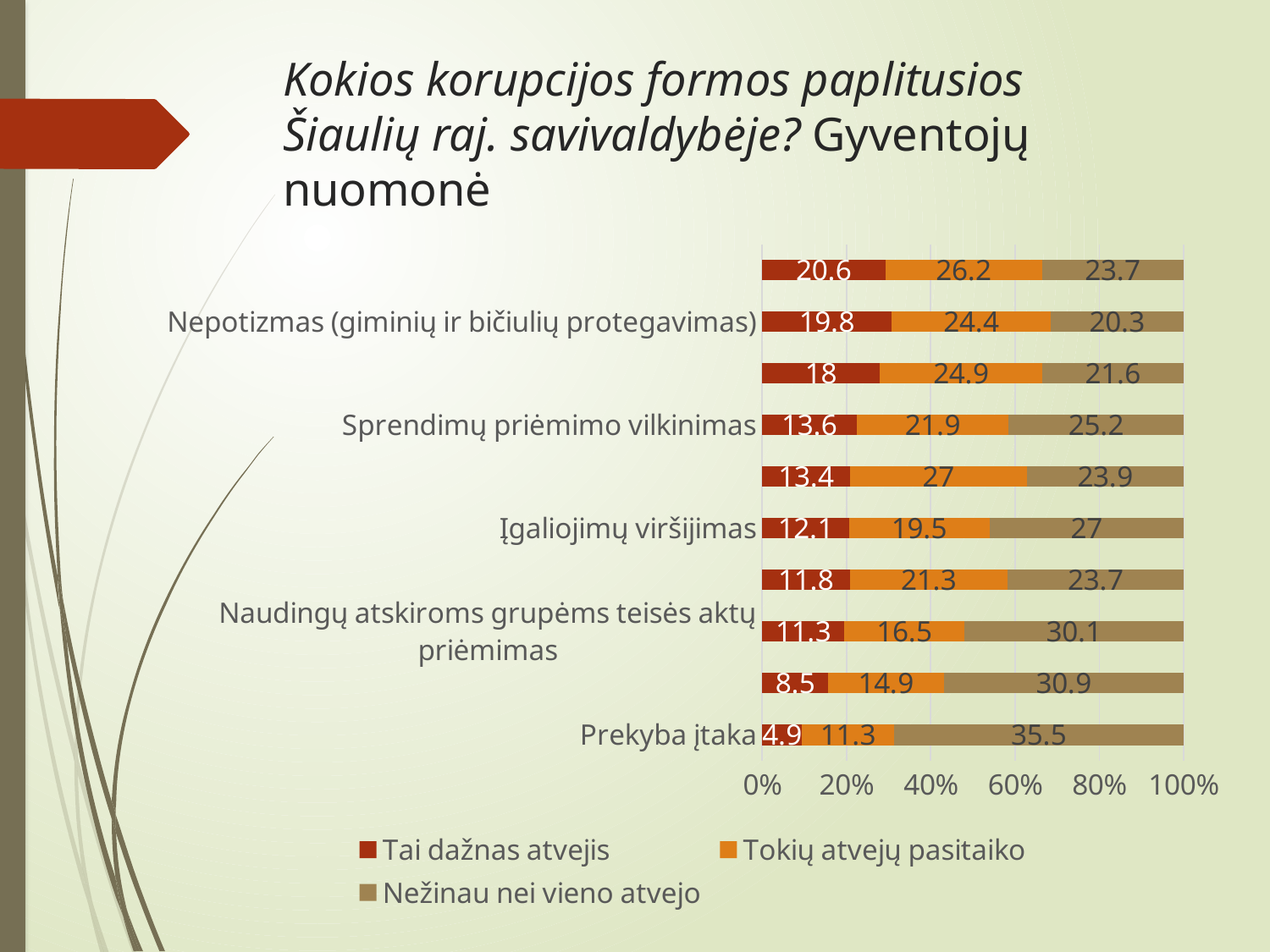
What is the difference between the "Nežinau nei vieno atvejo" values for Prekyba įtaka and Nepotizmas (giminių ir bičiulių protegavimas)? 15.2 Which bar has the lowest "Tai dažnas atvejis" value? Prekyba įtaka How many series does the legend list? 3 Which legend entry is shown in dark red? Tai dažnas atvejis What is the value of "Nežinau nei vieno atvejo" for Nepotizmas (giminių ir bičiulių protegavimas)? 20.3 What is the value of "Tokių atvejų pasitaiko" for Sprendimų priėmimo vilkinimas? 21.9 What is the value of "Nežinau nei vieno atvejo" for Įgaliojimų viršijimas? 27 What is the value of "Tai dažnas atvejis" for Naudingų atskiroms grupėms teisės aktų priėmimas? 11.3 Which has the larger "Tai dažnas atvejis" value: Nepotizmas (giminių ir bičiulių protegavimas) or Prekyba įtaka? Nepotizmas (giminių ir bičiulių protegavimas) What is the value of "Tai dažnas atvejis" for Prekyba įtaka? 4.9 How many bars are plotted in the chart? 10 What kind of chart is shown on the slide? Stacked bar chart